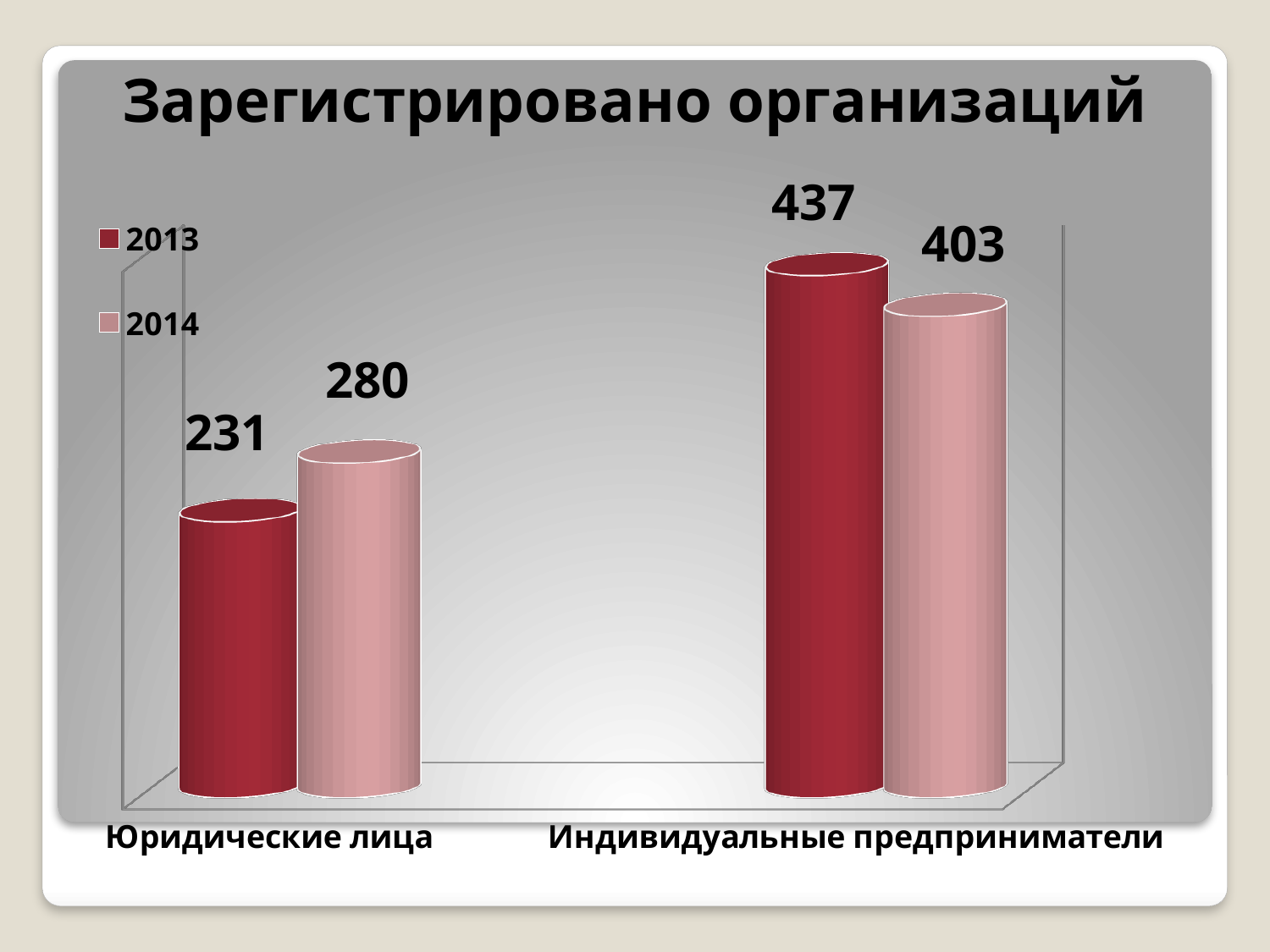
What is the value for Индивидуальные предприниматели in 2014? 403 What is the value for Юридические лица in 2014? 280 What is the difference between the 2014 and 2013 values for Юридические лица? 49 What is the difference between the 2013 and 2014 values for Индивидуальные предприниматели? 34 Which is larger for Индивидуальные предприниматели: the 2013 value or the 2014 value? 2013 What is the value for Юридические лица in 2013? 231 Which category has the lowest value in 2014? Юридические лица What kind of chart is shown on the slide? Bar chart How many series does the legend list? 2 How many categories are shown on the x axis? 2 Which category has the highest value in 2013? Индивидуальные предприниматели What is the value for Индивидуальные предприниматели in 2013? 437